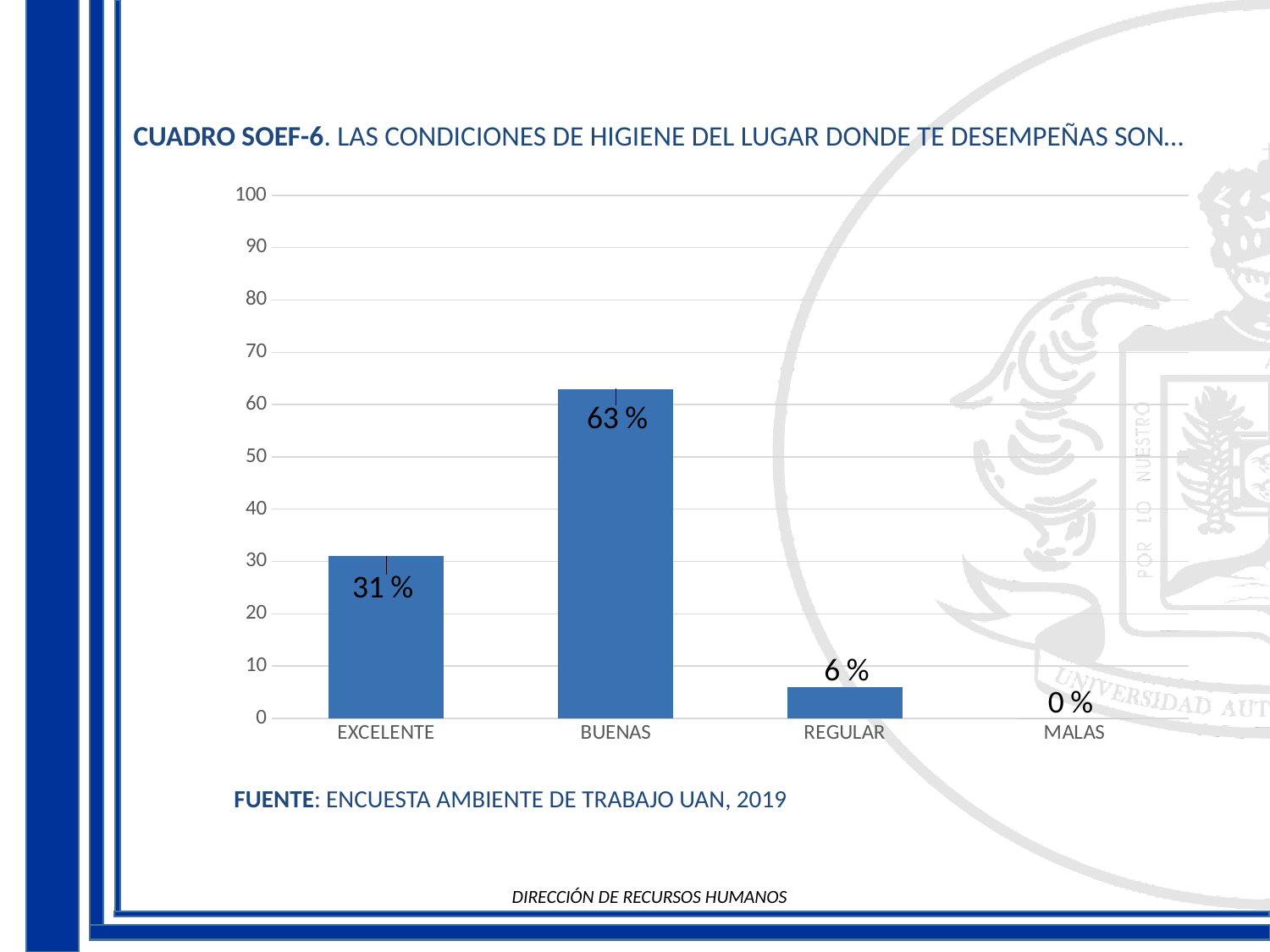
What is the value for BUENAS? 63 % Which category has the lowest value? MALAS What is the source cited below the chart? ENCUESTA AMBIENTE DE TRABAJO UAN, 2019 Which category has the highest value? BUENAS What is the value for MALAS? 0 % What is the value for EXCELENTE? 31 % What is the difference between the values for BUENAS and EXCELENTE? 32 % Which is larger, the value for EXCELENTE or the value for REGULAR? EXCELENTE What is the value for REGULAR? 6 % How many categories are shown on the x axis? 4 Is the value for BUENAS greater or less than 50? greater What kind of chart is shown on the slide? Bar chart